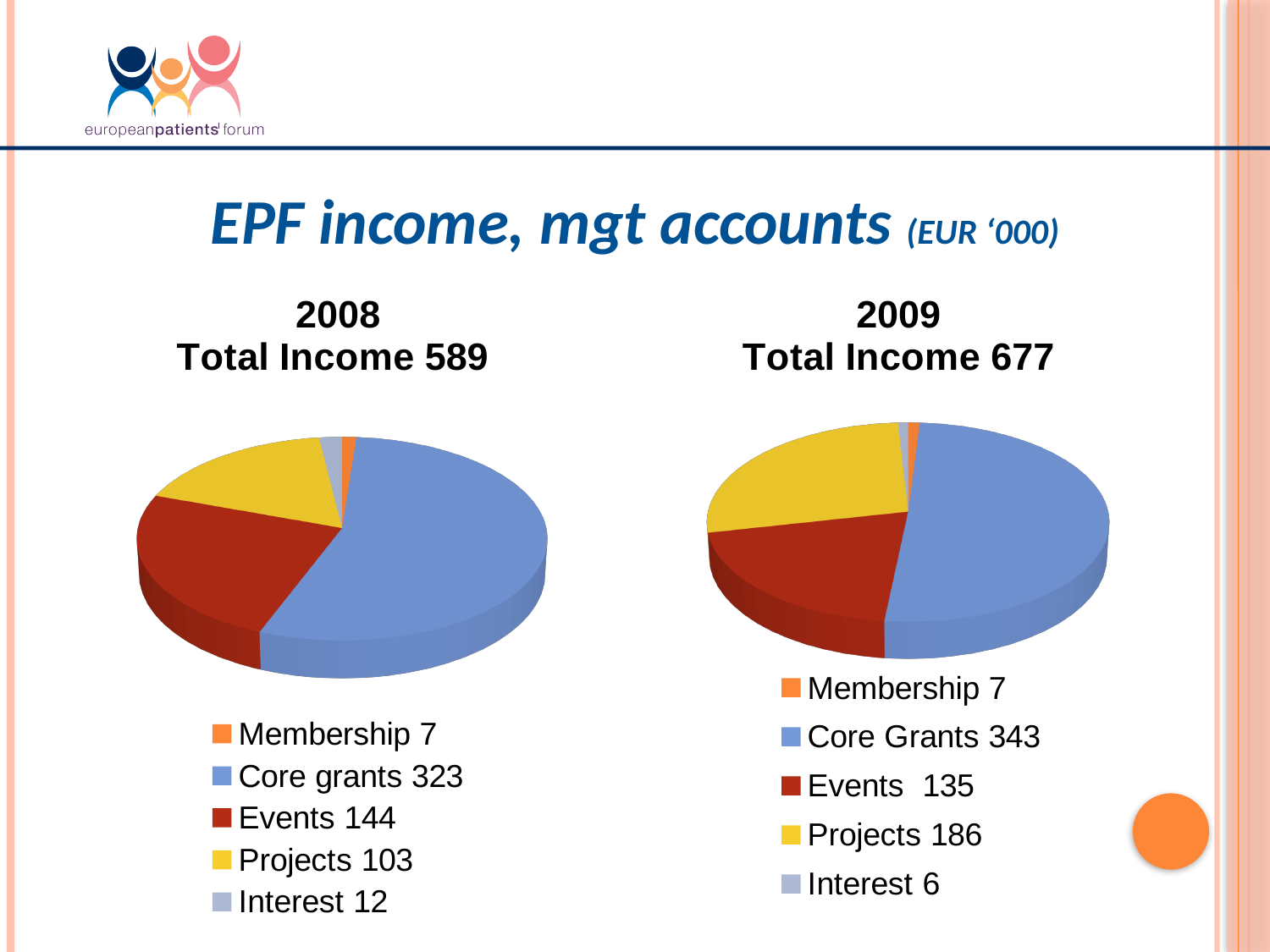
In the 2009 pie chart, how much larger is Projects than Events? 51 In the 2009 pie chart, which category has the smallest value? Interest In the 2009 pie chart, what is the value for Projects? 186 What is the title of the slide's charts? EPF income, mgt accounts (EUR '000) In the 2008 pie chart, which is larger, Events or Projects? Events In the 2008 pie chart, what is the value for Core grants? 323 In the 2008 pie chart, what is the value for Interest? 12 What kind of chart is used for the 2009 Total Income 677 data? Pie chart In the 2008 pie chart, which category has the smallest value? Membership In the 2009 pie chart, which category has the largest value? Core Grants What is the difference between Core Grants in the 2009 chart and Core grants in the 2008 chart? 20 How many categories does the 2008 pie chart show? 5